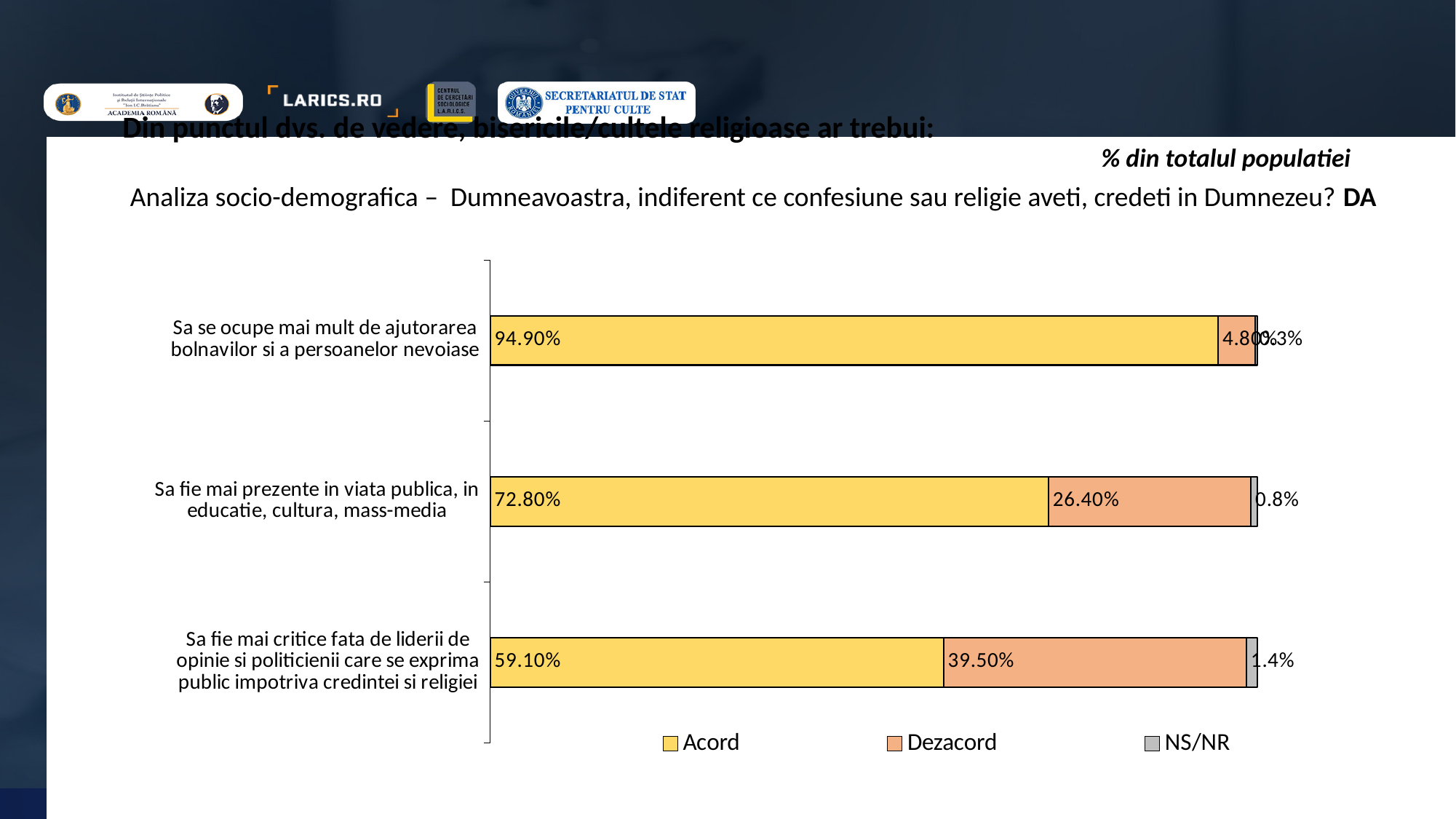
Which is larger: the Dezacord value for 'Sa fie mai critice fata de liderii de opinie...' or the Dezacord value for 'Sa fie mai prezente in viata publica...'? Sa fie mai critice fata de liderii de opinie si politicienii care se exprima public impotriva credintei si religiei What kind of chart is shown on the slide? Stacked bar chart What is the Dezacord value for 'Sa fie mai prezente in viata publica, in educatie, cultura, mass-media'? 26.40% Which legend entry is shown in orange? Dezacord What is the Acord value for 'Sa fie mai critice fata de liderii de opinie si politicienii care se exprima public impotriva credintei si religiei'? 59.10% How many categories are shown in the chart? 3 Which category has the highest Acord value? Sa se ocupe mai mult de ajutorarea bolnavilor si a persoanelor nevoiase What is the difference between the Acord values for 'Sa se ocupe mai mult de ajutorarea bolnavilor si a persoanelor nevoiase' and 'Sa fie mai prezente in viata publica, in educatie, cultura, mass-media'? 22.10% What is the NS/NR value for 'Sa fie mai critice fata de liderii de opinie si politicienii care se exprima public impotriva credintei si religiei'? 1.4% How many series does the legend list? 3 Which category has the lowest Dezacord value? Sa se ocupe mai mult de ajutorarea bolnavilor si a persoanelor nevoiase What is the Acord value for 'Sa se ocupe mai mult de ajutorarea bolnavilor si a persoanelor nevoiase'? 94.90%